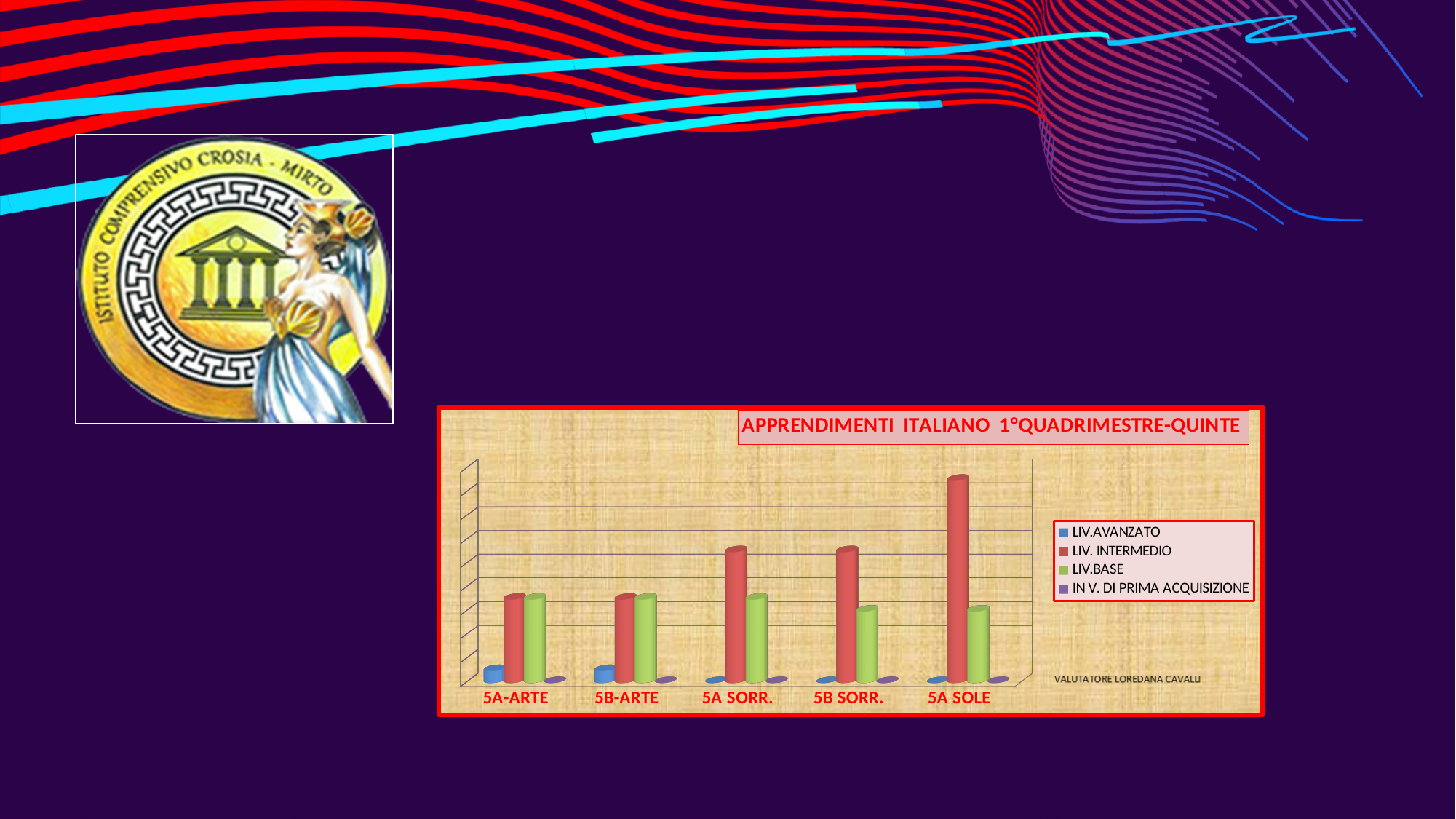
What kind of chart is shown on the slide? bar chart For 5A SOLE, which is larger: LIV. INTERMEDIO or LIV.BASE? LIV. INTERMEDIO What is the title of the chart? APPRENDIMENTI ITALIANO 1°QUADRIMESTRE-QUINTE Which class has the larger LIV.AVANZATO bar: 5B-ARTE or 5A SORR.? 5B-ARTE For 5B SORR., which is larger: LIV. INTERMEDIO or LIV.BASE? LIV. INTERMEDIO How many series does the chart's legend list? 4 Which class has the tallest bar in the whole chart? 5A SOLE What colour represents LIV.BASE in the chart's legend? green Which class has the highest LIV. INTERMEDIO bar? 5A SOLE How many classes (categories) are shown on the x axis of the chart? 5 Which series has the tallest bar for 5A SORR.? LIV. INTERMEDIO